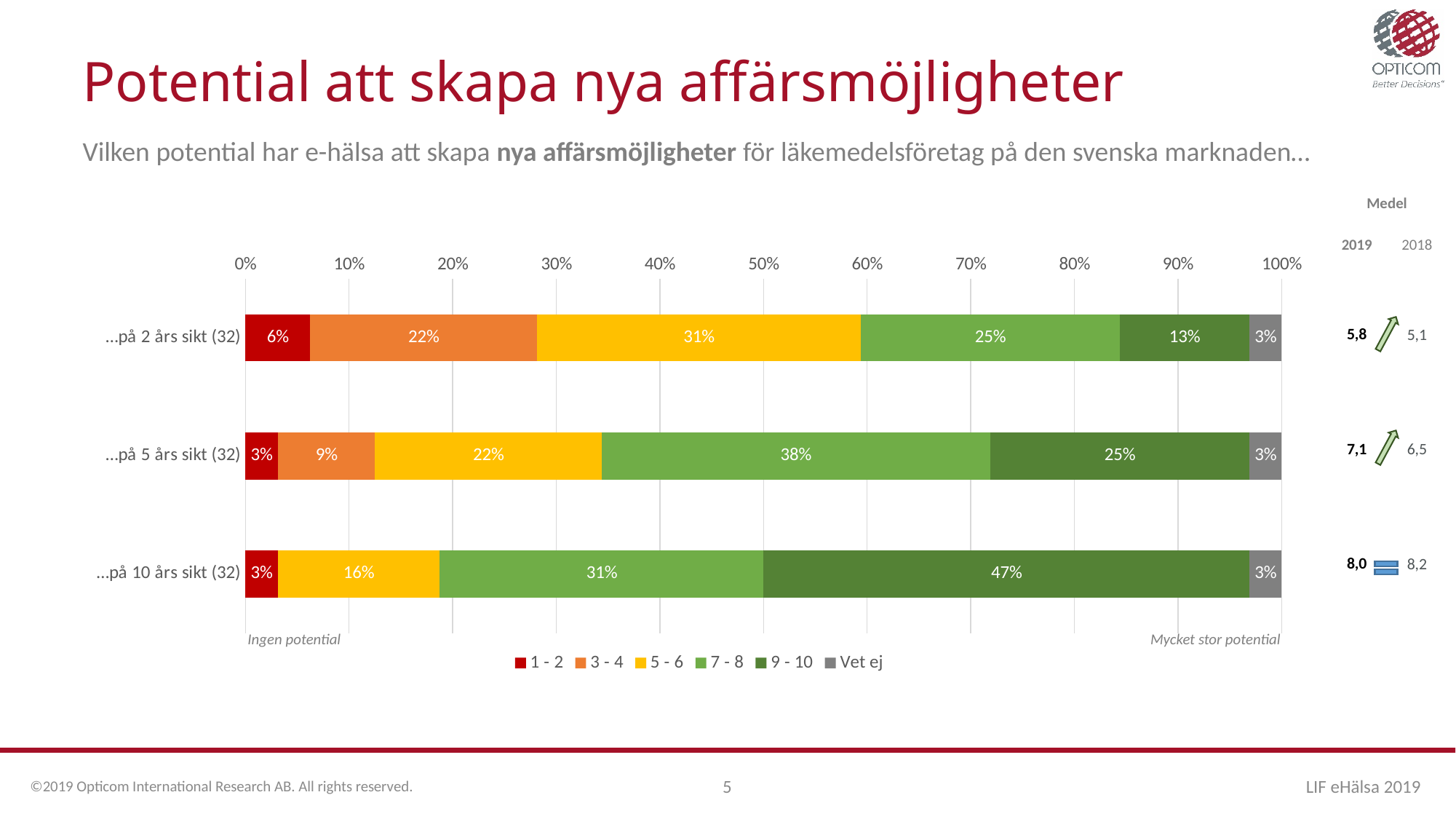
What kind of chart is shown on the slide? Stacked bar chart Which is larger: the 3 - 4 value for "...på 2 års sikt (32)" or the 3 - 4 value for "...på 5 års sikt (32)"? ...på 2 års sikt (32) What is the value of the 7 - 8 series for "...på 5 års sikt (32)"? 38% Which category has the lowest value for the 5 - 6 series? ...på 10 års sikt (32) What is the 2019 mean (Medel) shown for "...på 5 års sikt (32)"? 7,1 What is the difference between the 9 - 10 values for "...på 10 års sikt (32)" and "...på 2 års sikt (32)"? 34% How many series does the chart legend list? 6 What is the value of the 5 - 6 series for "...på 2 års sikt (32)"? 31% How many categories (bars) are plotted in the chart? 3 Which category has the highest value for the 9 - 10 series? ...på 10 års sikt (32) What is the value of the 1 - 2 series for "...på 2 års sikt (32)"? 6% What is the value of the 9 - 10 series for "...på 10 års sikt (32)"? 47%